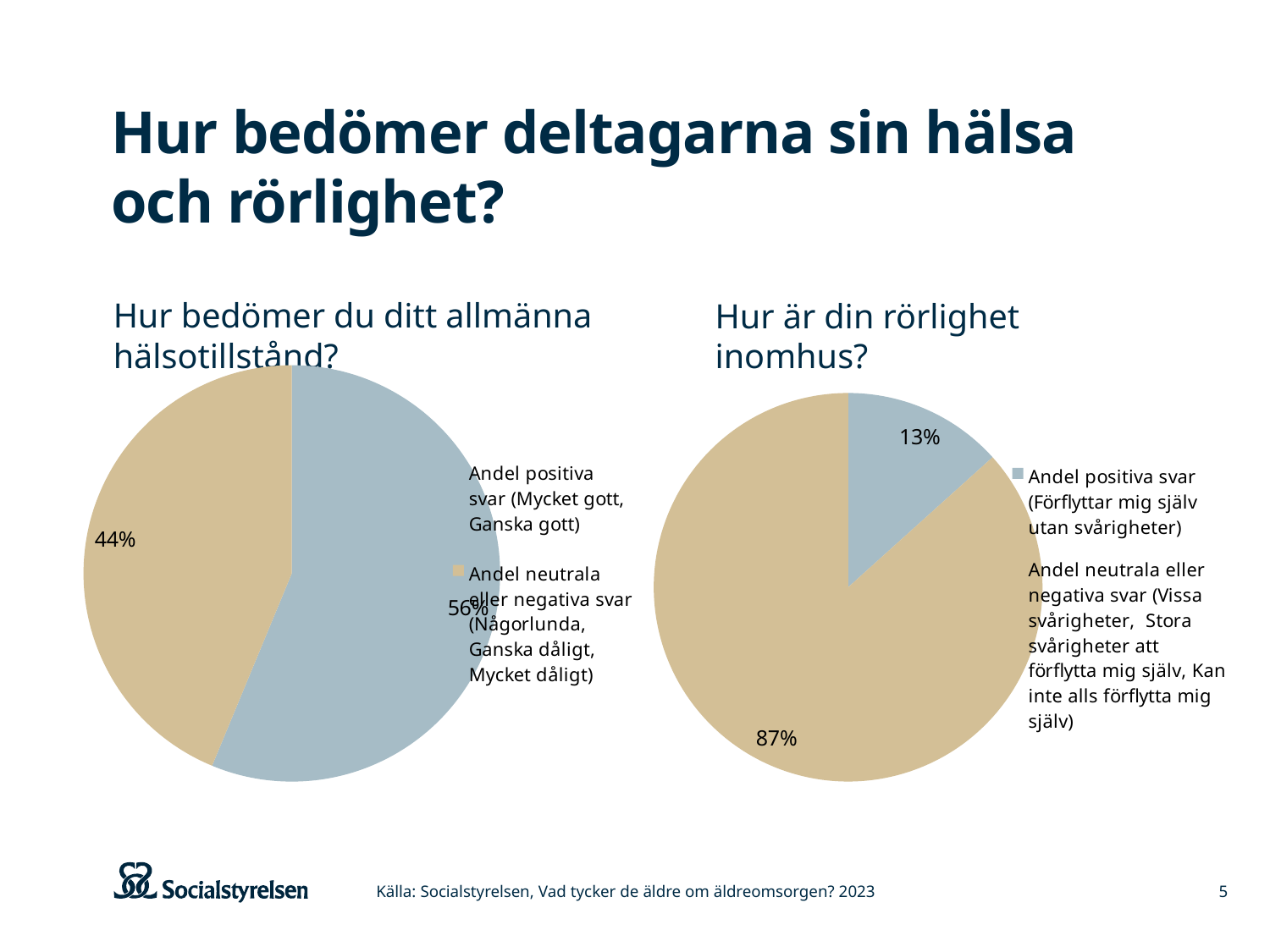
In the left chart (Hur bedömer du ditt allmänna hälsotillstånd?), what share of answers are neutral or negative? 44% In the right chart (Hur är din rörlighet inomhus?), what share of answers are neutral or negative? 87% In the left chart (Hur bedömer du ditt allmänna hälsotillstånd?), what share of answers are positive (Mycket gott, Ganska gott)? 56% In the left chart (Hur bedömer du ditt allmänna hälsotillstånd?), what is the difference in percentage points between the positive and the neutral/negative share? 12 percentage points In the right chart (Hur är din rörlighet inomhus?), what is the difference in percentage points between the neutral/negative and the positive share? 74 percentage points What type of chart is used on this slide? Pie chart In the left chart (Hur bedömer du ditt allmänna hälsotillstånd?), which category has the smallest slice? Andel neutrala eller negativa svar What is the title of the left chart? Hur bedömer du ditt allmänna hälsotillstånd? Which chart has the larger share of positive answers, the left one (allmänna hälsotillstånd) or the right one (rörlighet inomhus)? The left one (allmänna hälsotillstånd) In the right chart (Hur är din rörlighet inomhus?), which category has the largest slice? Andel neutrala eller negativa svar In the right chart (Hur är din rörlighet inomhus?), what share of answers are positive (Förflyttar mig själv utan svårigheter)? 13% How many slices does the right chart (Hur är din rörlighet inomhus?) have? 2